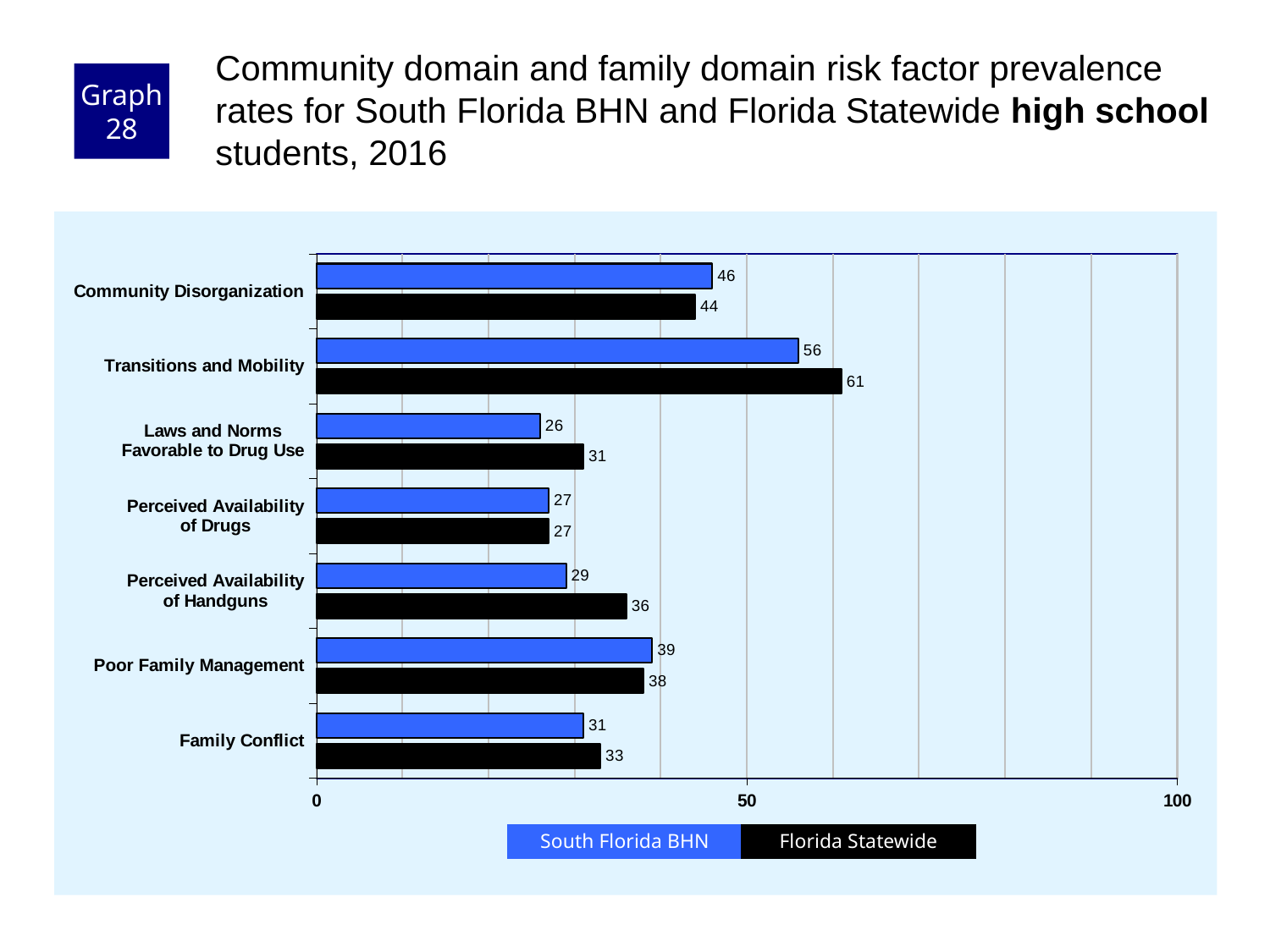
Which category has the lowest South Florida BHN value? Laws and Norms Favorable to Drug Use What is the difference between the Florida Statewide and South Florida BHN values for Transitions and Mobility? 5 For Poor Family Management, which is larger: the South Florida BHN value or the Florida Statewide value? South Florida BHN What is the South Florida BHN value for Transitions and Mobility? 56 Which category has the highest Florida Statewide value? Transitions and Mobility What is the Florida Statewide value for Community Disorganization? 44 How many series does the legend list? 2 What is the difference between the Florida Statewide and South Florida BHN values for Perceived Availability of Handguns? 7 What is the Florida Statewide value for Perceived Availability of Handguns? 36 What kind of chart is shown on the slide? Bar chart Is the Florida Statewide value for Transitions and Mobility greater or less than 50? greater How many risk factor categories are shown on the chart? 7